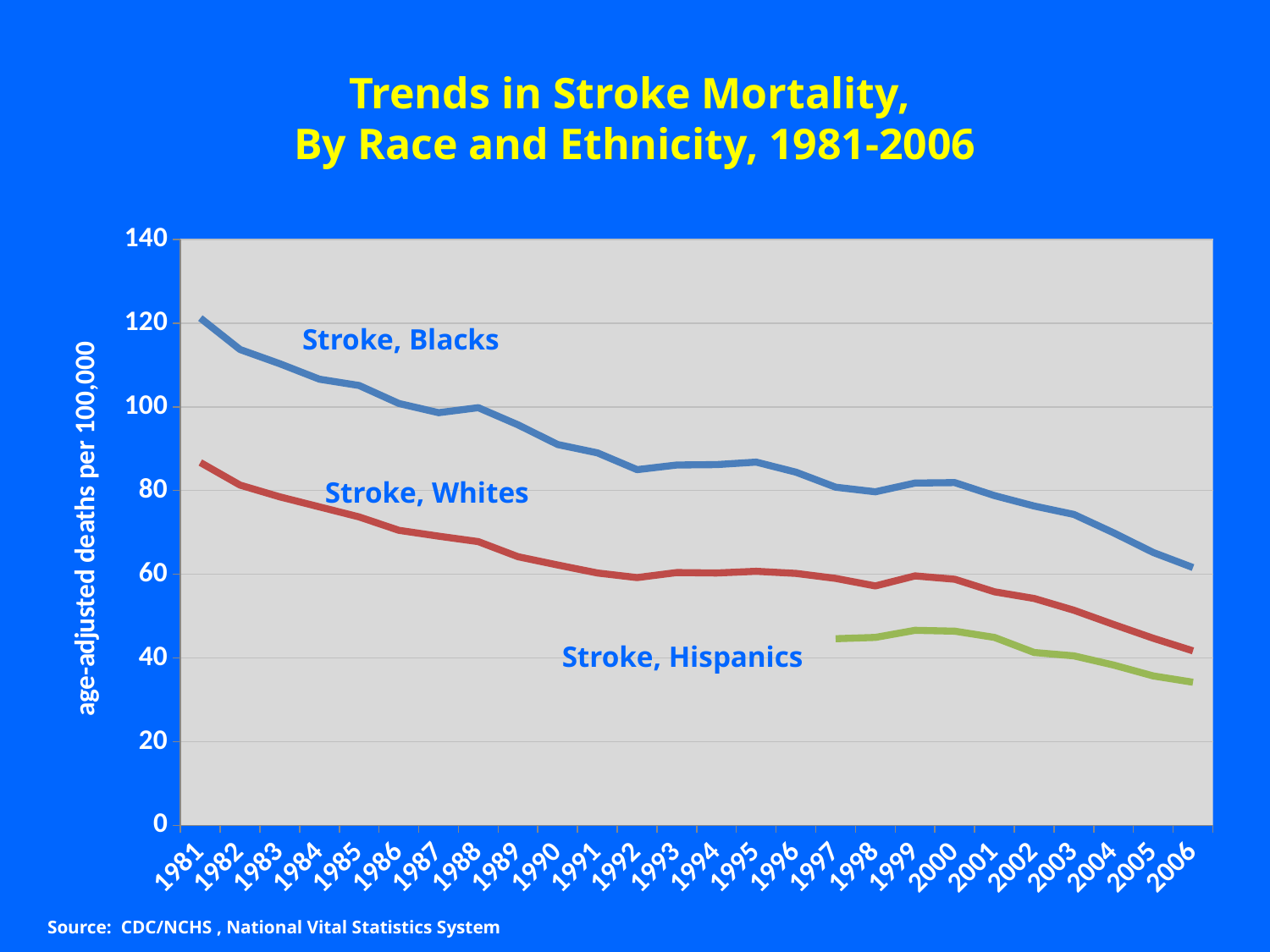
Is the value for Stroke, Blacks in 2003 greater or less than 80? less In 2006, which is larger: the value for Stroke, Whites or Stroke, Hispanics? Stroke, Whites What is the label on the y axis of the chart? age-adjusted deaths per 100,000 Which series has the highest stroke mortality rate throughout the chart? Stroke, Blacks Is the value for Stroke, Whites in 1981 greater or less than 80? greater Is the value for Stroke, Blacks in 1985 greater or less than 100? greater Which series has the lowest stroke mortality rate in 2006? Stroke, Hispanics Does the stroke mortality rate for Blacks rise or fall from 1981 to 2006? fall How many years are labelled along the x axis? 26 How many series are plotted on the chart? 3 What kind of chart is shown on the slide? line chart